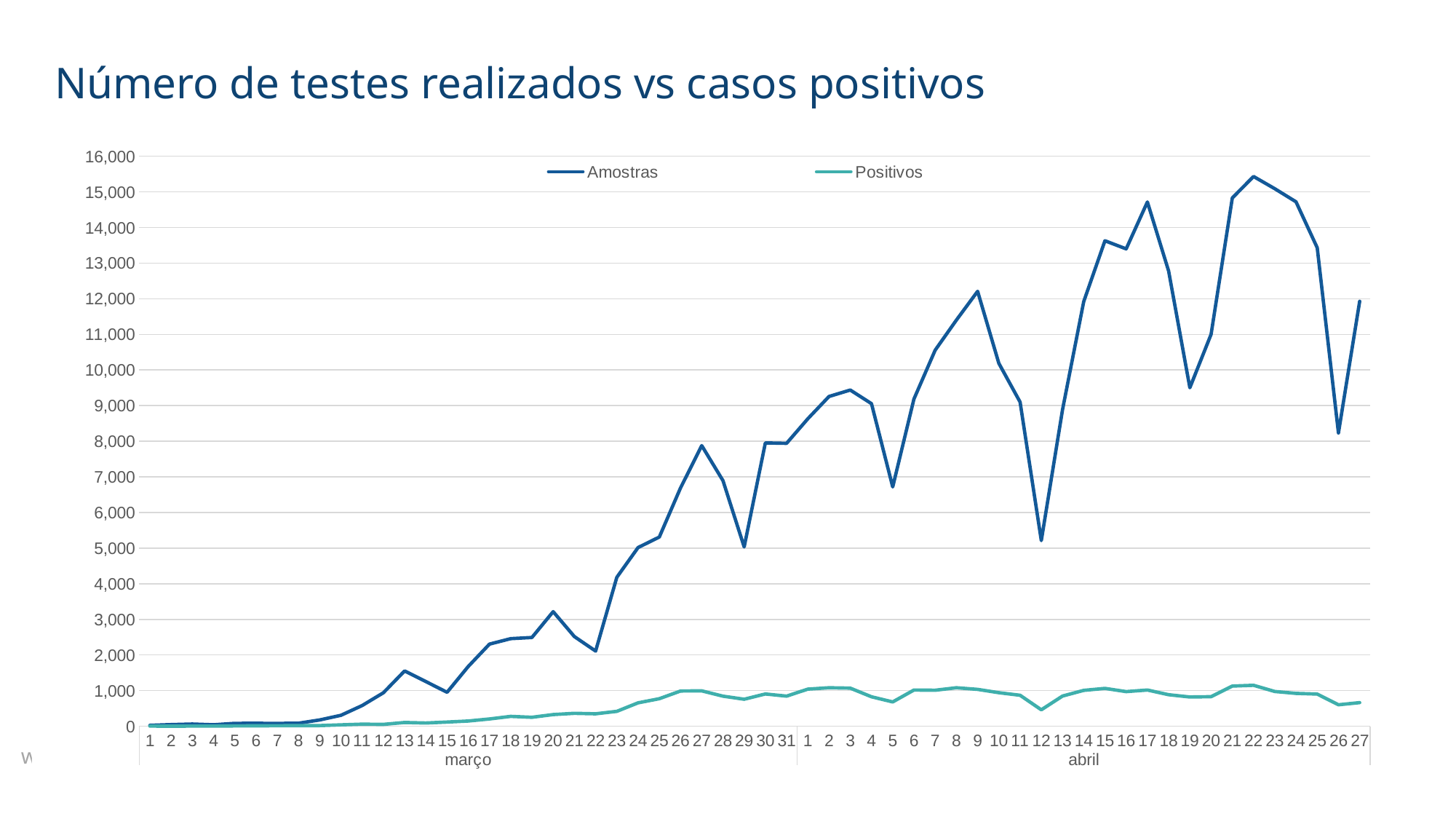
Which two months are labelled on the x axis? março and abril Is the value of Amostras on 20 março greater or less than 2,000? greater Is the value of Amostras on 26 abril greater or less than 9,000? less On which date does the Amostras series reach its highest value? 22 abril What are the two series named in the legend? Amostras and Positivos Which is larger, the Amostras value on 17 abril or on 19 abril? 17 abril Is the value of Amostras on 12 abril greater or less than 6,000? less What is the title of the chart? Número de testes realizados vs casos positivos Overall, does the Amostras series rise or fall from the start of março to the end of abril? rise What kind of chart is shown on the slide? line chart How many series does the legend list? 2